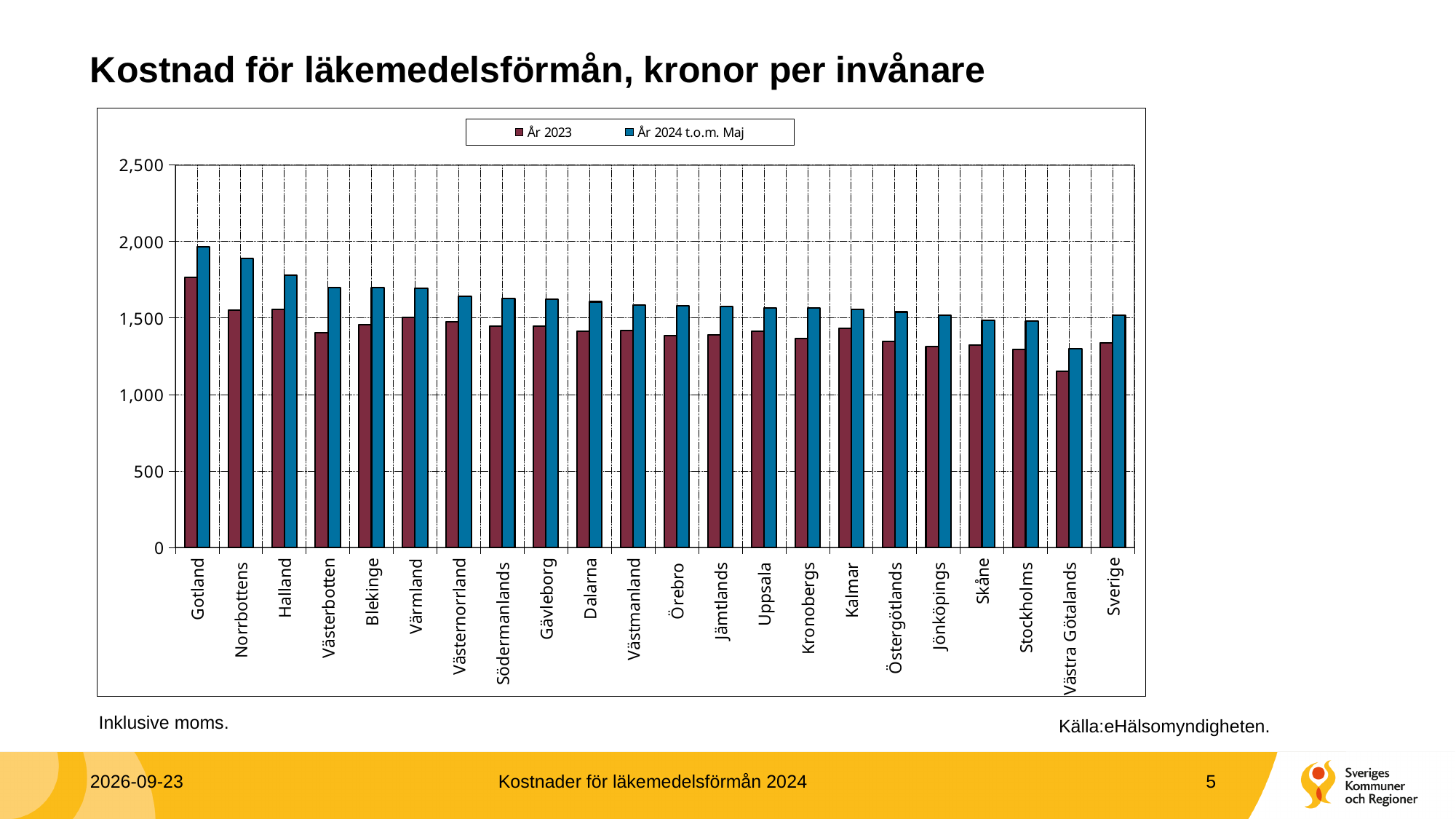
Which is larger for År 2023: Halland or Västerbotten? Halland Is the value for Norrbottens in År 2024 t.o.m. Maj greater or less than 1,500? greater What is the title of the chart? Kostnad för läkemedelsförmån, kronor per invånare Do the values for År 2024 t.o.m. Maj generally rise or fall from Gotland to Västra Götalands along the x axis? fall How many categories are shown on the x axis? 22 Which category has the highest value for År 2024 t.o.m. Maj? Gotland Which category has the lowest value for År 2023? Västra Götalands Is the value for Gotland in År 2024 t.o.m. Maj greater or less than 2,000? less What kind of chart is shown on the slide? Bar chart Is the value for Västra Götalands in År 2023 greater or less than 1,000? greater How many series does the legend list? 2